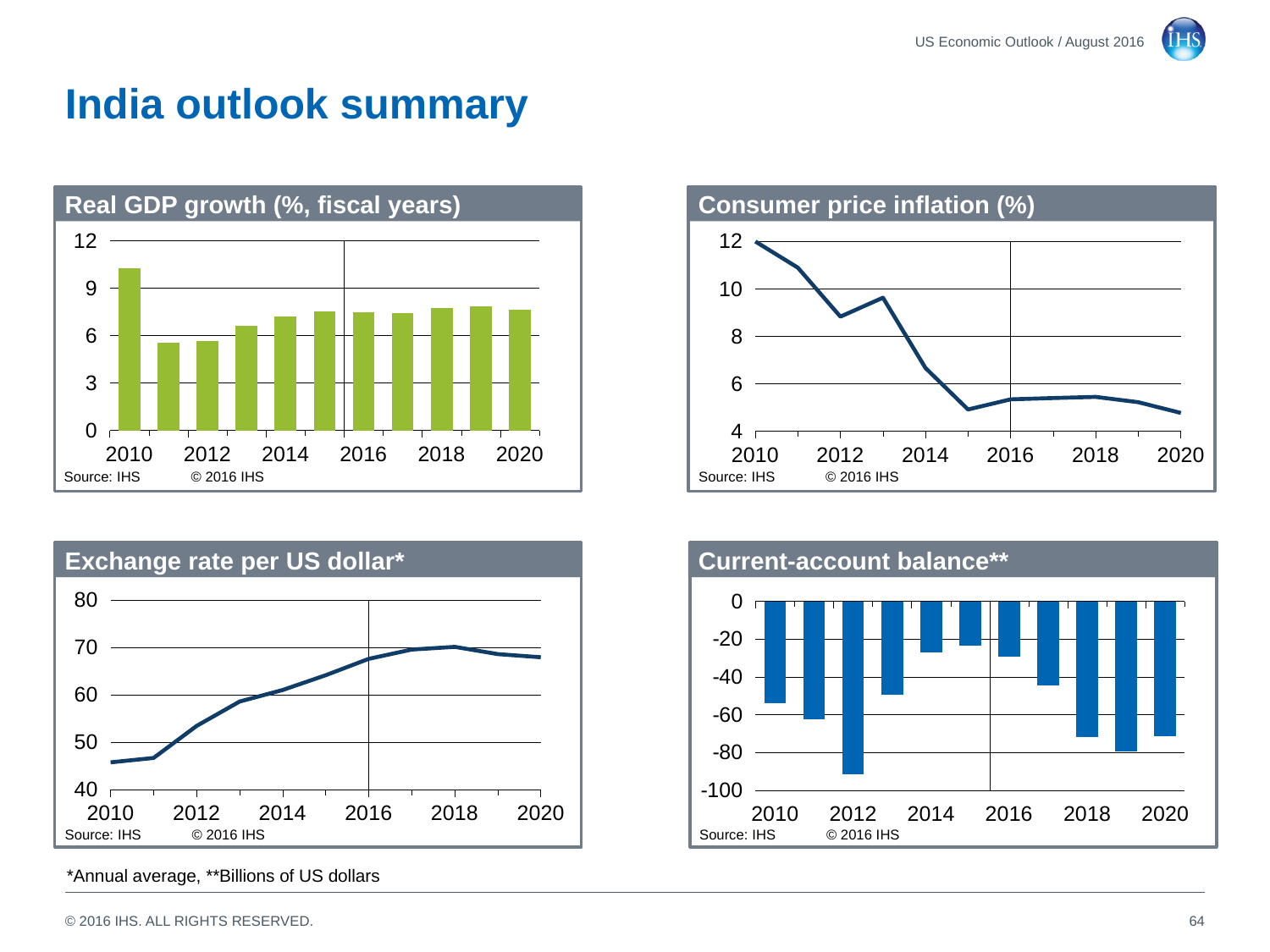
In the 'Consumer price inflation (%)' chart, do values generally rise or fall from 2010 to 2020? fall In the 'Exchange rate per US dollar*' chart, which year has the lowest value? 2010 In the 'Current-account balance**' chart, which year has the lowest (most negative) value? 2012 How many bars are plotted in the 'Real GDP growth (%, fiscal years)' chart? 11 In the 'Real GDP growth (%, fiscal years)' chart, is the value for 2010 greater or less than 9? greater In the 'Consumer price inflation (%)' chart, is the value for 2016 greater or less than 6? less In the 'Exchange rate per US dollar*' chart, is the value for 2016 greater or less than 60? greater In the 'Real GDP growth (%, fiscal years)' chart, which year has the highest value? 2010 What kind of chart is the 'Real GDP growth (%, fiscal years)' chart? bar chart What kind of chart is the 'Consumer price inflation (%)' chart? line chart In the 'Consumer price inflation (%)' chart, which year has the highest value? 2010